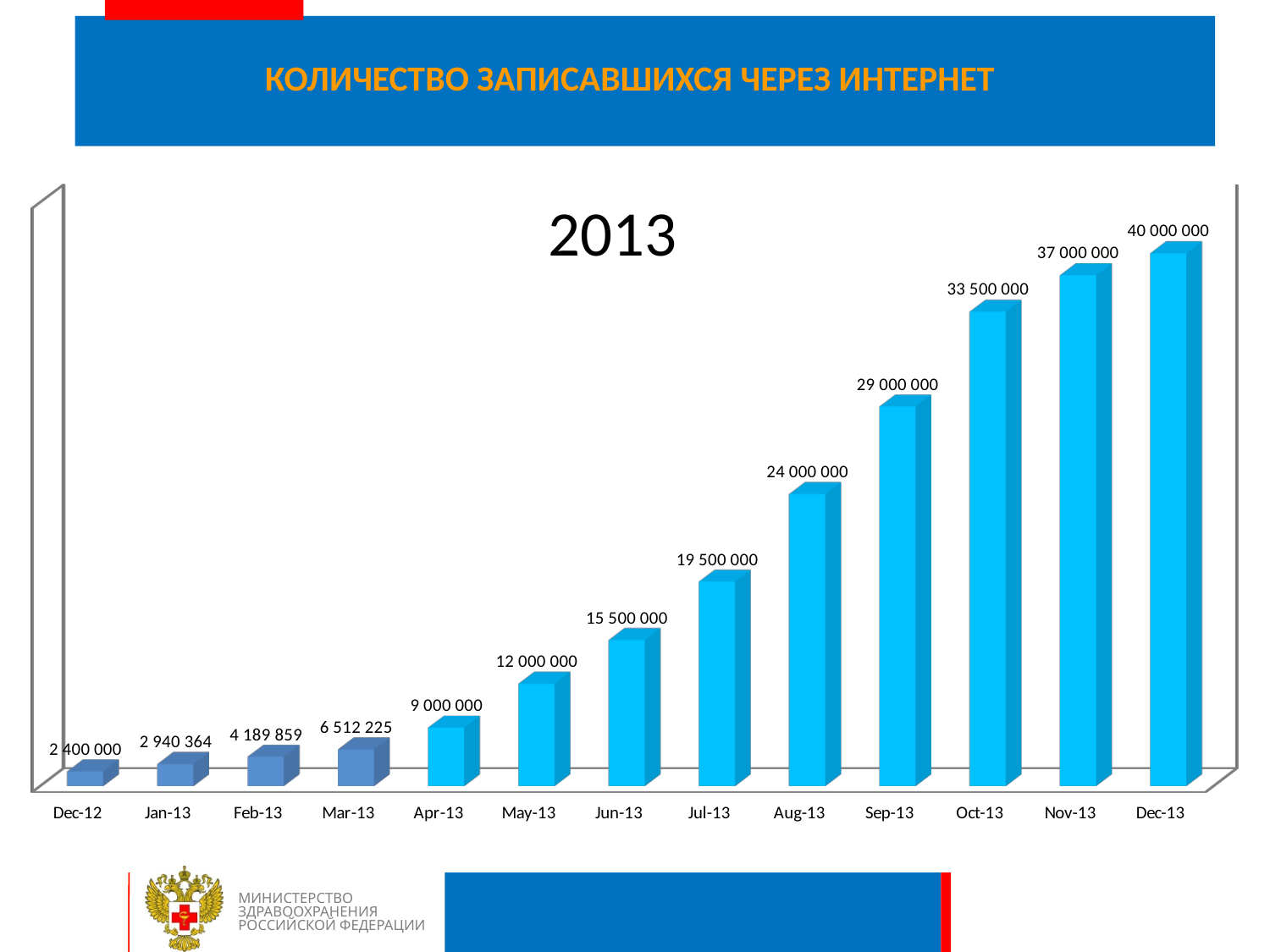
Which is larger, the value for Aug-13 or the value for Sep-13? Sep-13 Do the values rise or fall from Dec-12 to Dec-13? Rise Which month has the highest value? Dec-13 Which month has the lowest value? Dec-12 How many months are shown on the x axis? 13 What is the value for Jul-13? 19 500 000 What is the difference between the values for Nov-13 and Oct-13? 3 500 000 What is the value for Mar-13? 6 512 225 What is the value for Dec-13? 40 000 000 What is the value for Jan-13? 2 940 364 What kind of chart is shown on the slide? Bar chart What is the difference between the values for Dec-13 and Dec-12? 37 600 000